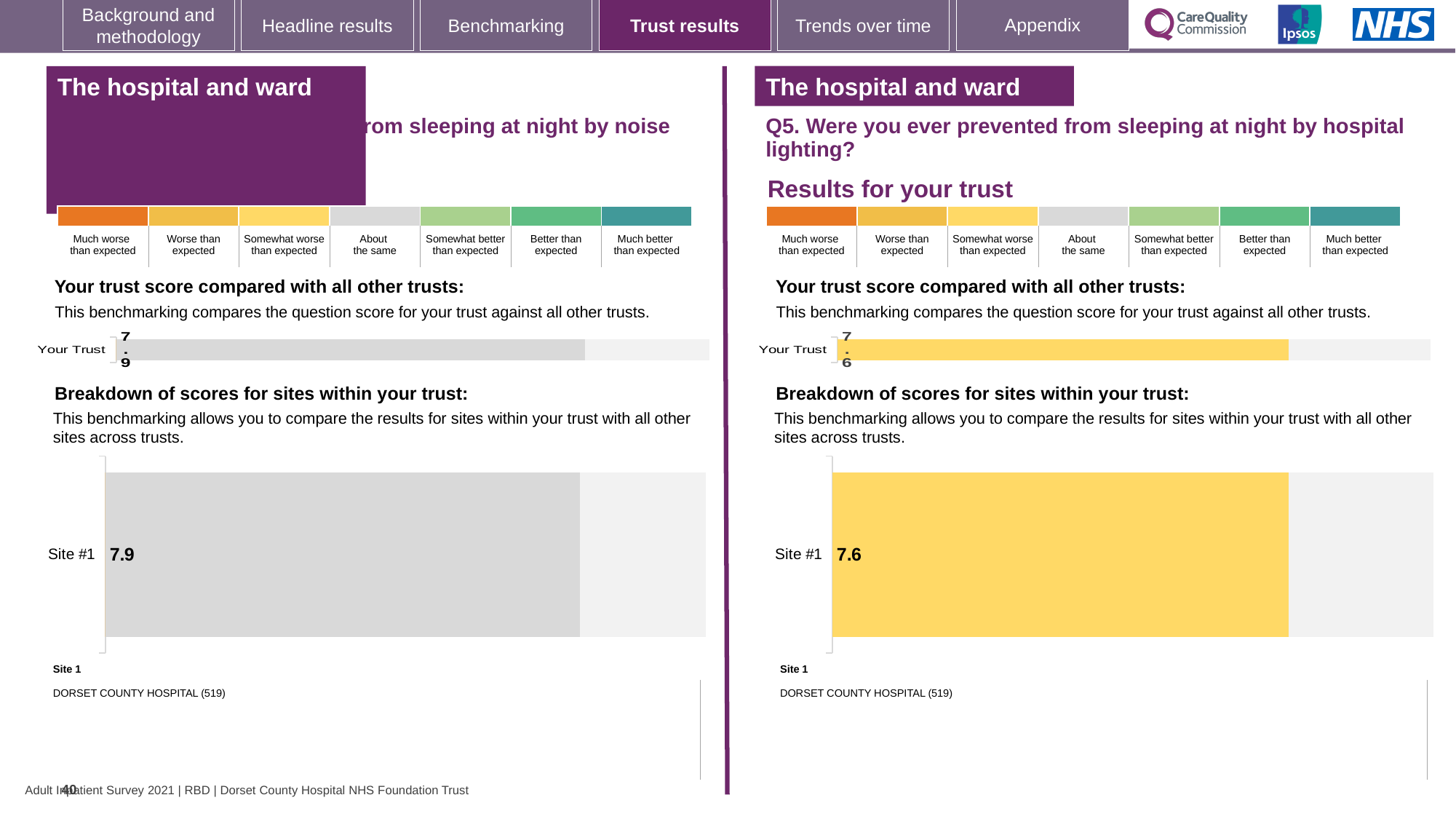
In the 'Breakdown of scores for sites within your trust' chart on the right-hand side (Q5, hospital lighting), what is the score for Site #1? 7.6 In the 'Breakdown of scores for sites within your trust' chart on the left-hand side (the question about noise), what is the score for Site #1? 7.9 What is the difference between the Your Trust score on the left-hand side (noise) and the Your Trust score on the right-hand side (Q5, hospital lighting)? 0.3 On the right-hand side of the slide (Q5, hospital lighting), what is the score shown for Your Trust? 7.6 Which is larger: the Site #1 score on the left-hand chart (noise) or the Site #1 score on the right-hand chart (Q5, hospital lighting)? The left-hand chart (noise), 7.9 Which site name is listed under Site 1 on the right-hand side (Q5, hospital lighting)? DORSET COUNTY HOSPITAL (519) How many sites are shown in the 'Breakdown of scores for sites within your trust' chart on the right-hand side (Q5, hospital lighting)? 1 On the left-hand side of the slide (the question about noise), what is the score shown for Your Trust? 7.9 What type of chart is used to show the Site #1 score on the right-hand side (Q5, hospital lighting)? Bar chart What colour is the Site #1 bar in the right-hand chart (Q5, hospital lighting)? Yellow What type of chart is used to show the Your Trust score on the left-hand side (noise)? Bar chart